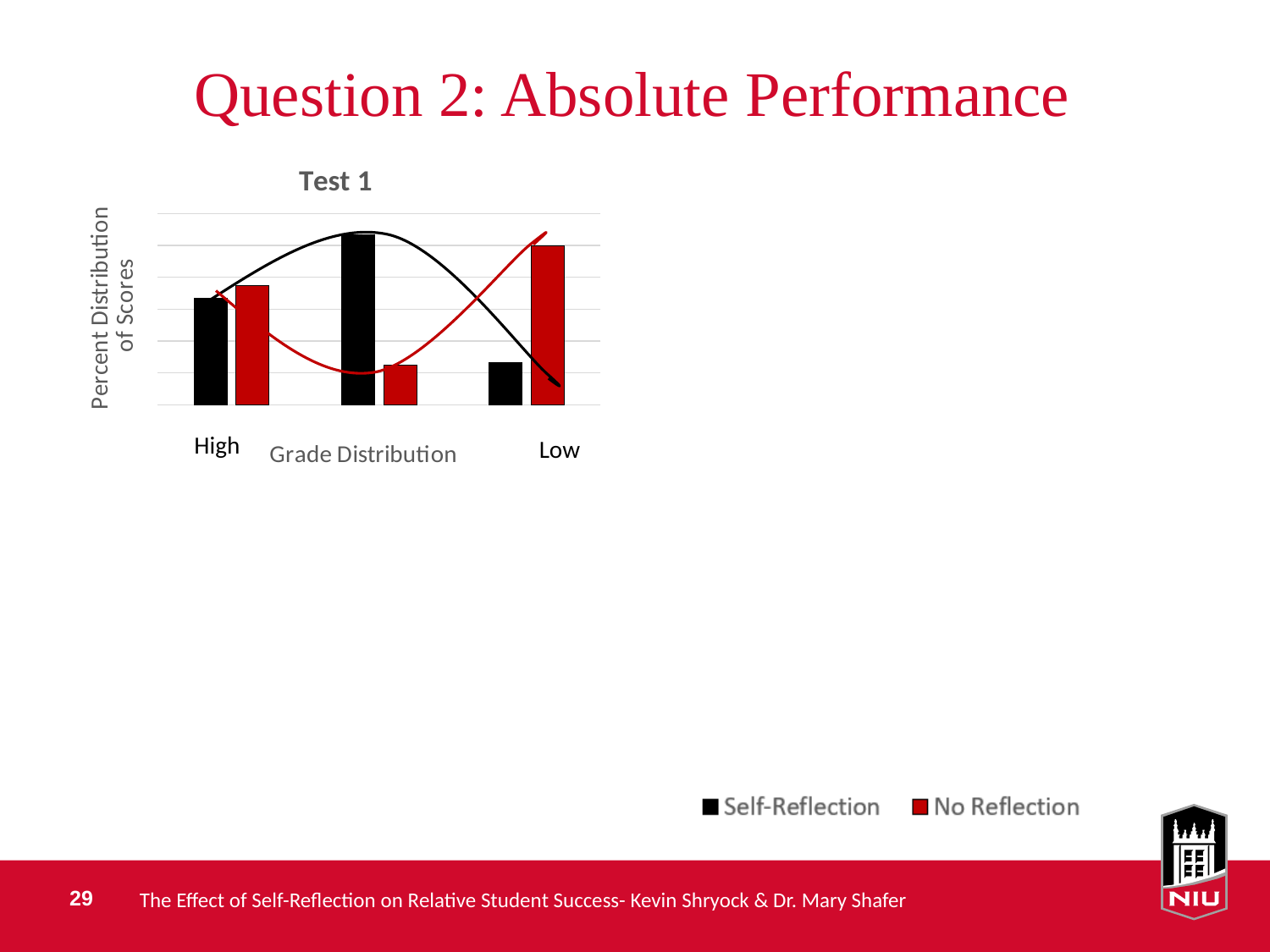
What is the title of the chart? Test 1 In the middle grade group, which series has the larger value, Self-Reflection or No Reflection? Self-Reflection What kind of chart is shown on the slide? bar chart For the No Reflection series, which grade group has the lowest bar? the middle group In the Low grade group, which series has the larger value, Self-Reflection or No Reflection? No Reflection How many series does the legend list? 2 How many grade groups (bar groups) are plotted along the x axis? 3 For the Self-Reflection series, which grade group has the lowest bar? Low For the Self-Reflection series, which grade group has the highest bar? the middle group Does the No Reflection series rise or fall from the middle grade group to the Low grade group? rise What are the two series named in the legend? Self-Reflection and No Reflection For the No Reflection series, which grade group has the highest bar? Low